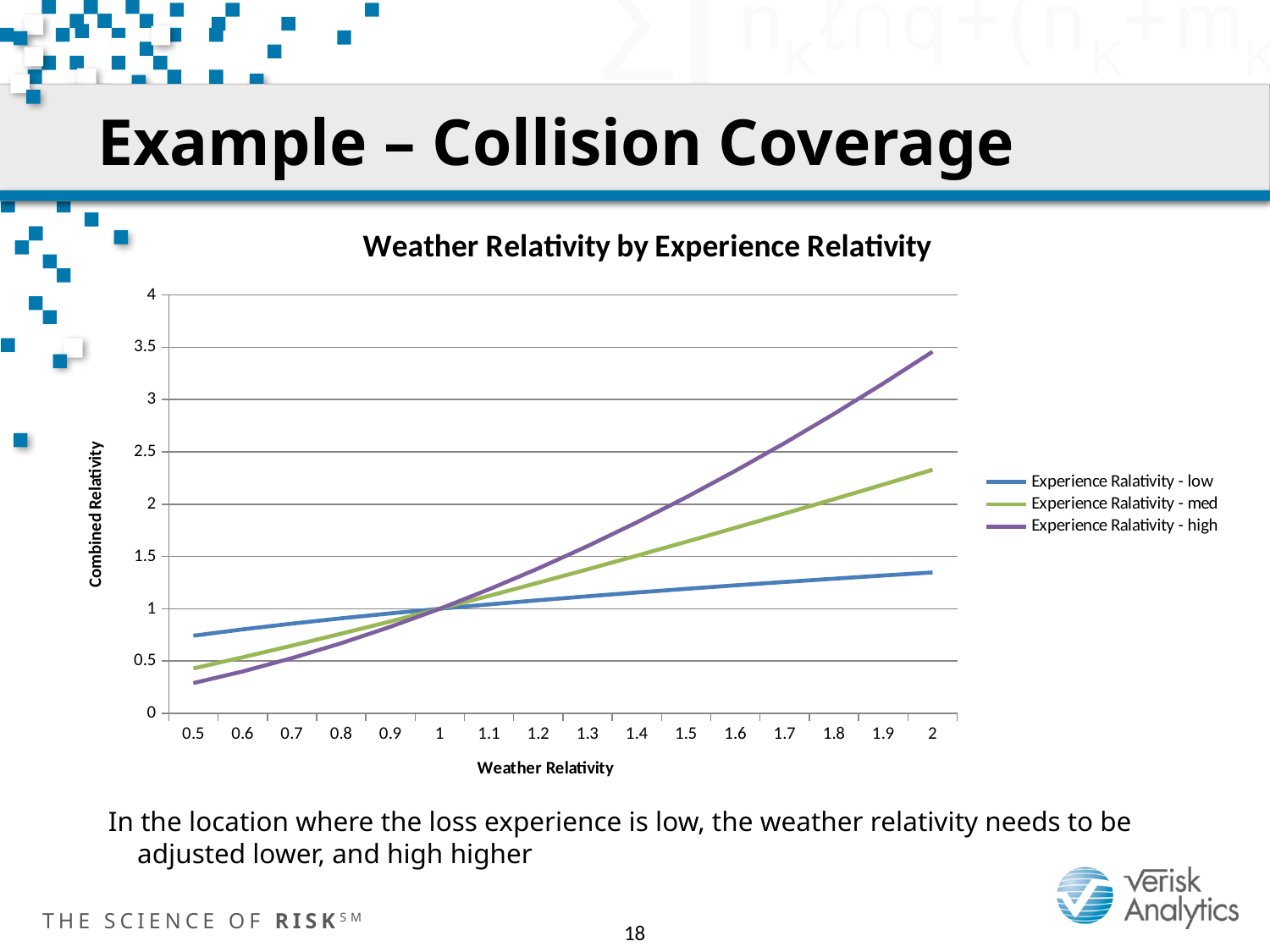
At a weather relativity of 0.5, which is larger: the combined relativity for Experience Relativity - low or for Experience Relativity - high? Experience Relativity - low How many series does the legend list? 3 At a weather relativity of 2, is the combined relativity for Experience Relativity - low greater or less than 1.5? less Does the Experience Relativity - high line rise or fall as weather relativity increases? rise What kind of chart is shown on the slide? line chart Which series has the lowest combined relativity at a weather relativity of 0.5? Experience Relativity - high What is the title of the chart? Weather Relativity by Experience Relativity At a weather relativity of 1, what combined relativity value do all three lines pass through? 1 What is the label of the y axis? Combined Relativity Which series has the highest combined relativity at a weather relativity of 2? Experience Relativity - high At a weather relativity of 2, is the combined relativity for Experience Relativity - high greater or less than 3? greater How many weather relativity values are marked along the x axis? 16